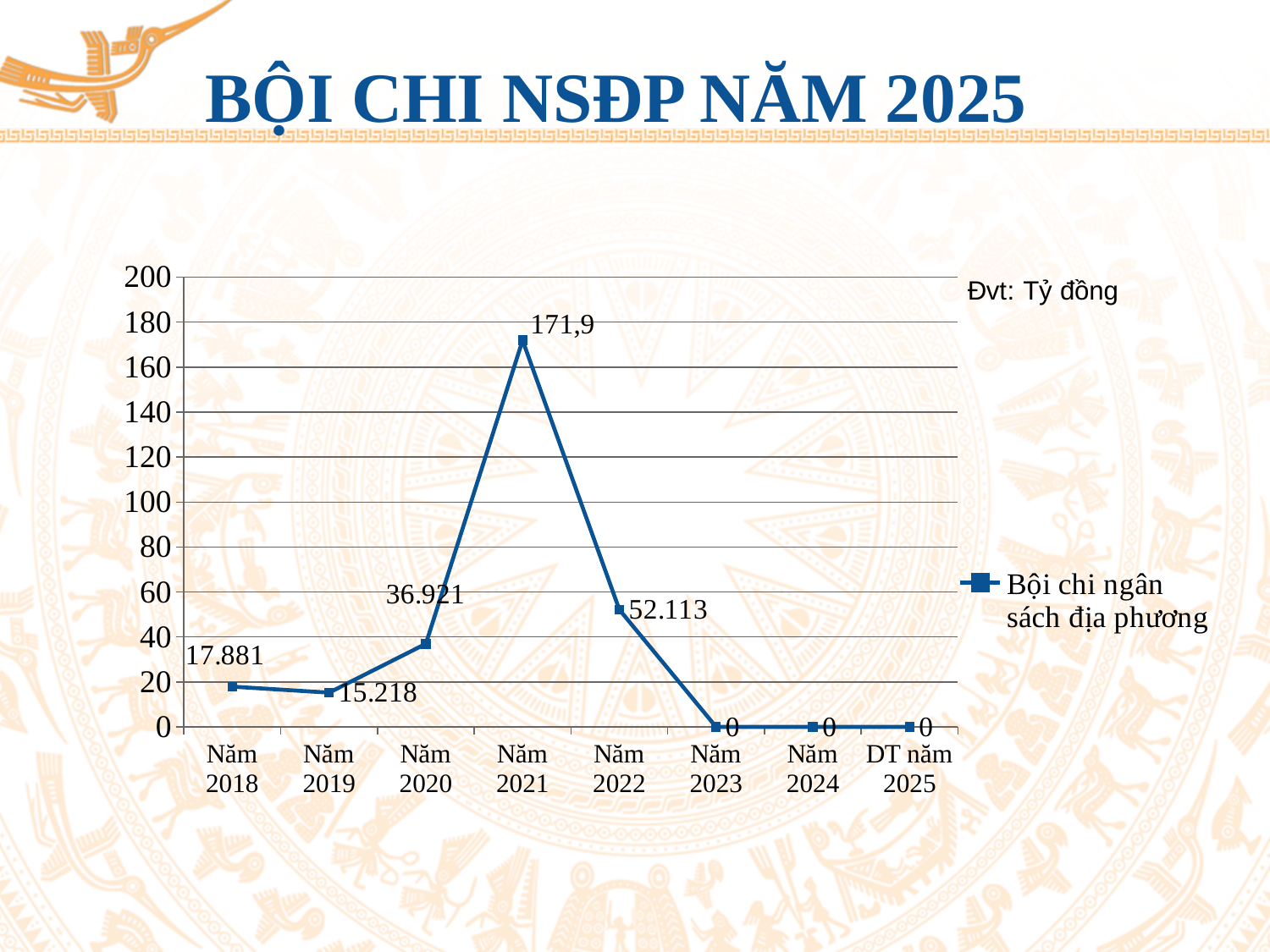
What kind of chart is shown on the slide? line chart What unit is stated for the chart values? Tỷ đồng Which category has the highest value? Năm 2021 How many series does the legend list? 1 What is the value for Năm 2021? 171,9 How many categories are shown on the x axis? 8 Which is larger, the value for Năm 2019 or Năm 2020? Năm 2020 What is the value for Năm 2020? 36.921 What is the value for Năm 2022? 52.113 Do the values rise or fall from Năm 2021 to Năm 2023? fall What is the value for DT năm 2025? 0 What is the value for Năm 2018? 17.881